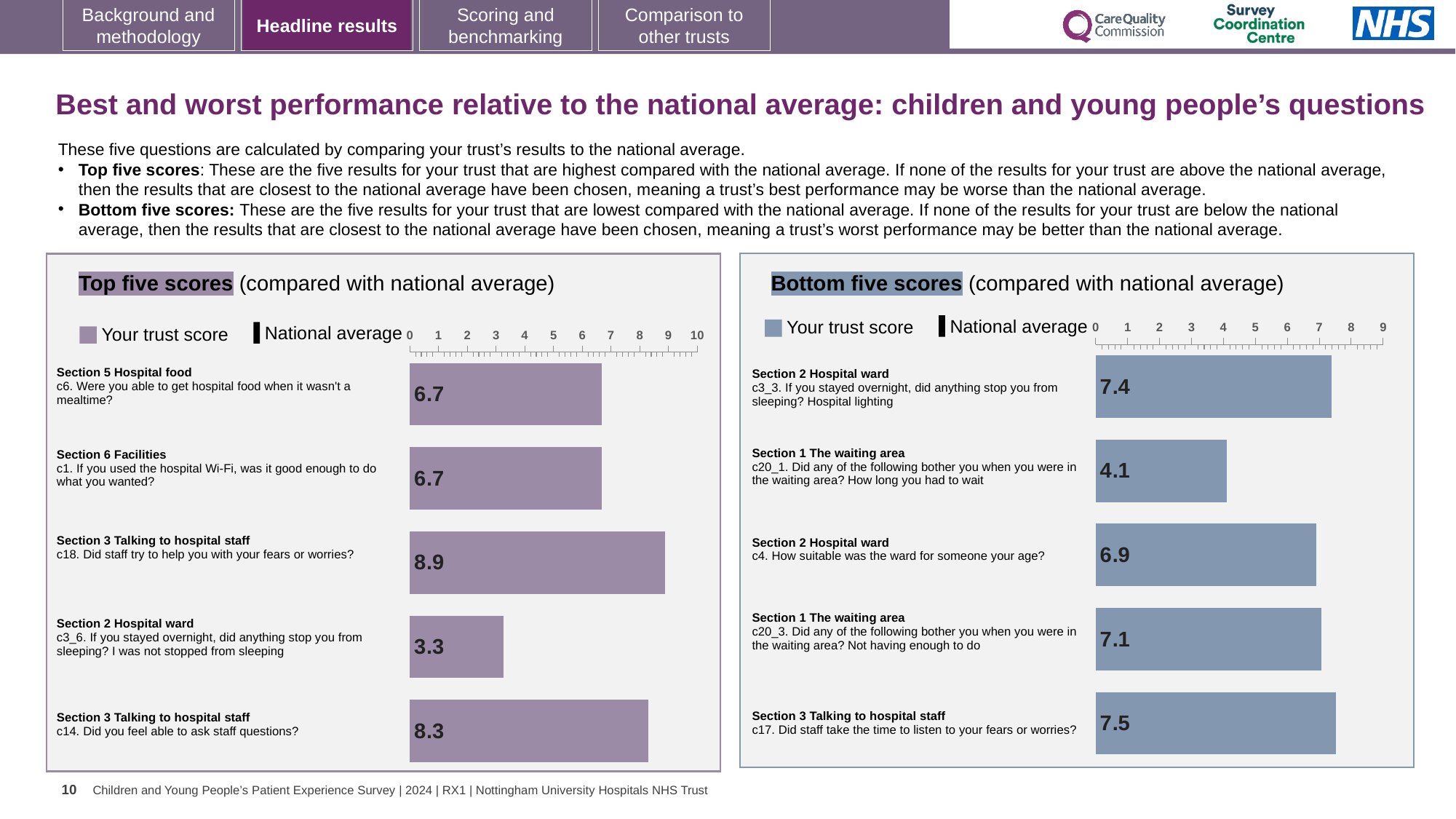
In the Top five scores chart, what is the trust score for c3_6 'I was not stopped from sleeping'? 3.3 In the Top five scores chart, which question has the highest trust score? c18. Did staff try to help you with your fears or worries? What type of chart is the Top five scores chart? Bar chart In the Top five scores chart, what is the trust score for c18 'Did staff try to help you with your fears or worries?' 8.9 In the Top five scores chart, what is the difference between the trust scores for c18 and c3_6? 5.6 How many bars are plotted in the Bottom five scores chart? 5 In the Bottom five scores chart, what is the trust score for c20_1 'How long you had to wait'? 4.1 In the Bottom five scores chart, what is the difference between the trust scores for c17 and c20_1? 3.4 In the Bottom five scores chart, which question has the highest trust score? c17. Did staff take the time to listen to your fears or worries? In the Top five scores chart, which has the larger trust score: c14 'Did you feel able to ask staff questions?' or c6 'Were you able to get hospital food when it wasn't a mealtime?' c14. Did you feel able to ask staff questions? In the Top five scores chart, which question has the lowest trust score? c3_6. If you stayed overnight, did anything stop you from sleeping? I was not stopped from sleeping In the Bottom five scores chart, which question has the lowest trust score? c20_1. Did any of the following bother you when you were in the waiting area? How long you had to wait